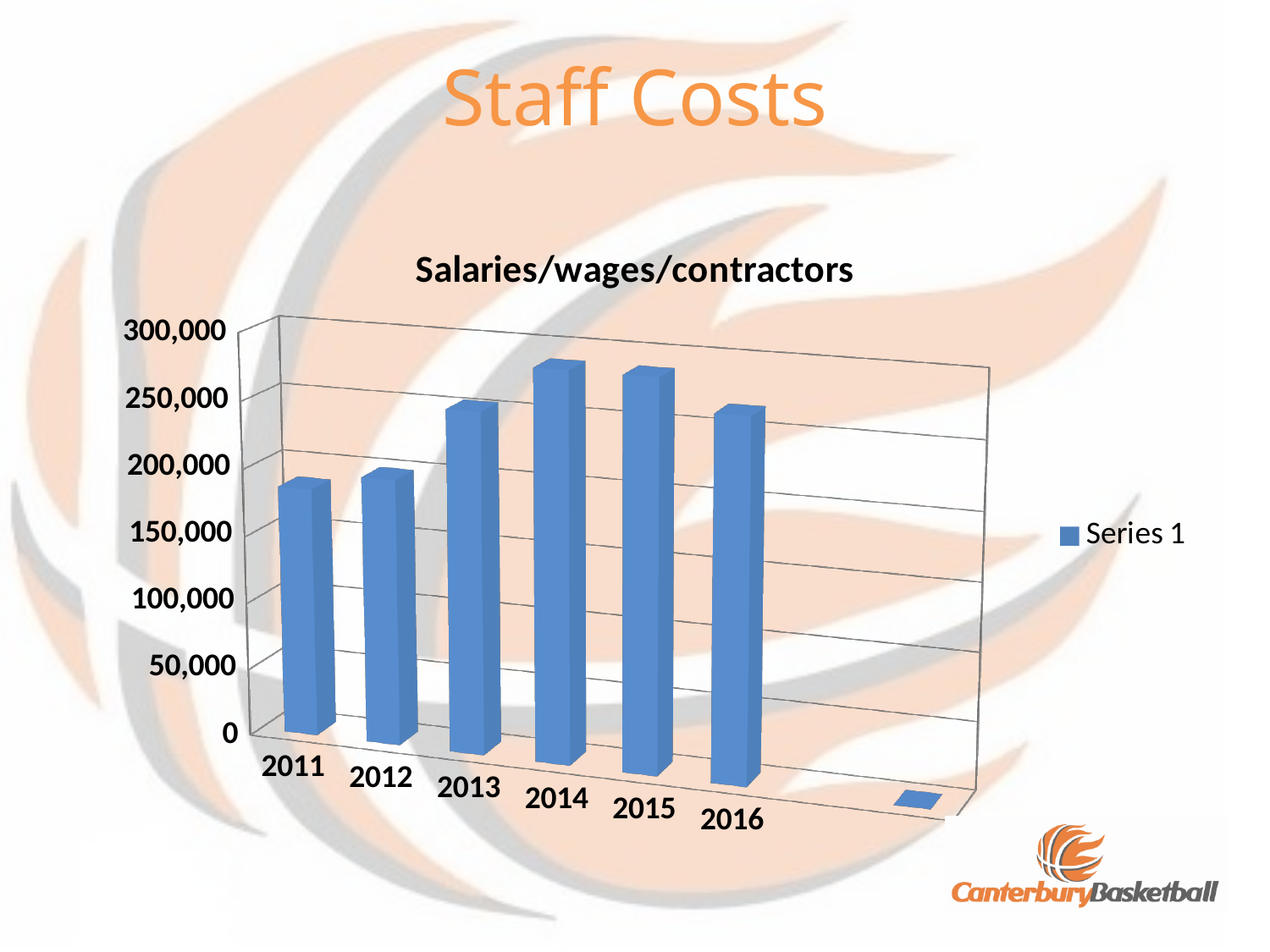
What kind of chart is shown on the slide? bar chart Which is larger, the value for 2011 or the value for 2014? 2014 Do the values rise or fall from 2011 to 2014? rise How many years are labelled on the x axis? 6 What is the name of the series shown in the legend? Series 1 Which is larger, the value for 2012 or the value for 2013? 2013 How many series does the legend list? 1 What is the title of the chart? Salaries/wages/contractors Is the value for 2012 greater or less than 150,000? greater Is the value for 2013 greater or less than 200,000? greater Is the value for 2011 greater or less than 200,000? less